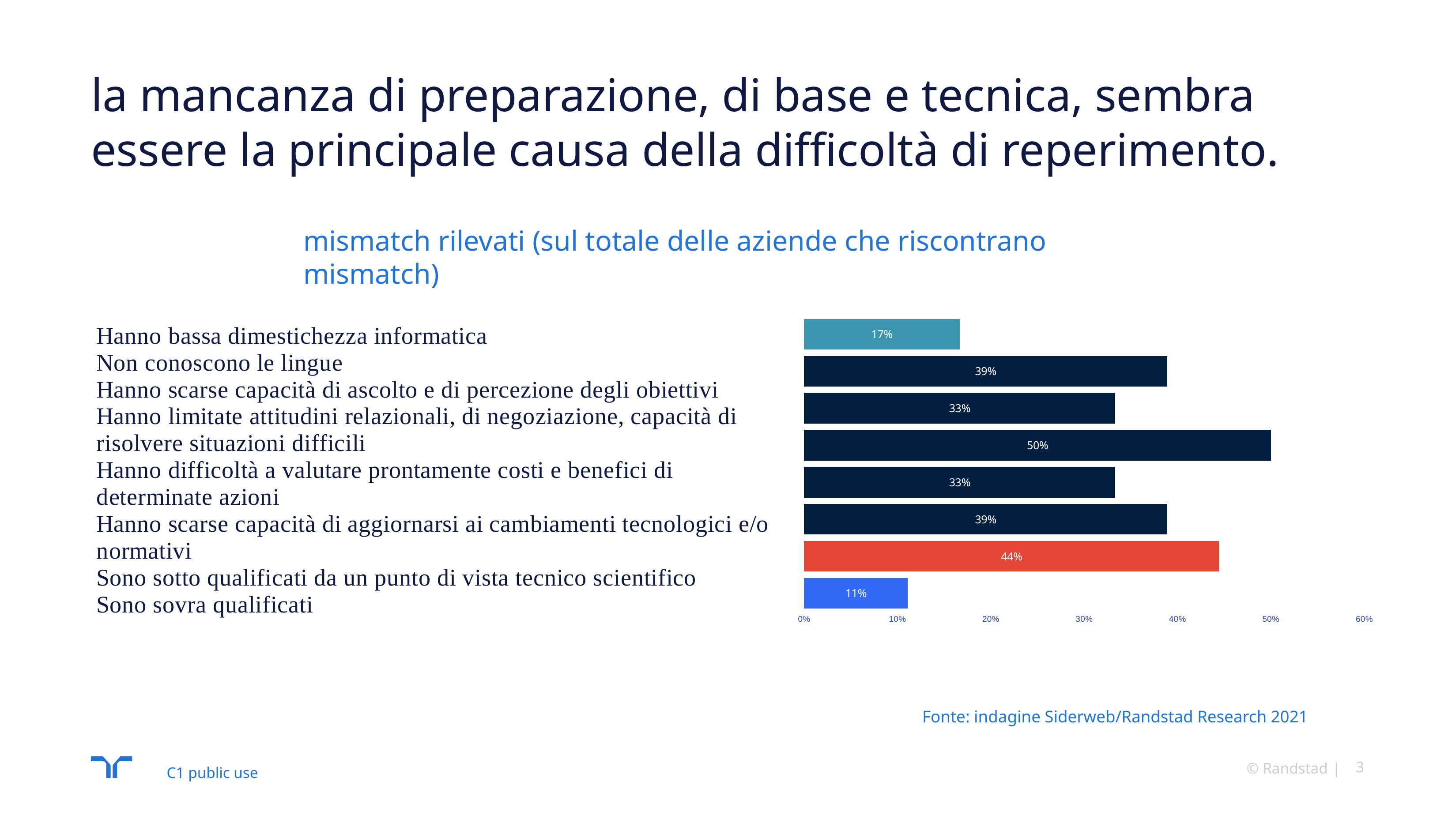
What type of chart is shown on the slide? bar chart Which category has the highest value? Hanno limitate attitudini relazionali, di negoziazione, capacità di risolvere situazioni difficili Which category has the lowest value? Sono sovra qualificati What is the value for "Sono sotto qualificati da un punto di vista tecnico scientifico"? 44% What is the value for "Non conoscono le lingue"? 39% What is the difference between the value for "Sono sotto qualificati da un punto di vista tecnico scientifico" and the value for "Sono sovra qualificati"? 33% How many bars does the chart contain? 8 What is the highest value shown on the x axis? 60% What is the title of the chart? mismatch rilevati (sul totale delle aziende che riscontrano mismatch) What is the value for "Sono sovra qualificati"? 11% What is the value for "Hanno bassa dimestichezza informatica"? 17% Which is larger: the value for "Non conoscono le lingue" or the value for "Hanno scarse capacità di ascolto e di percezione degli obiettivi"? Non conoscono le lingue